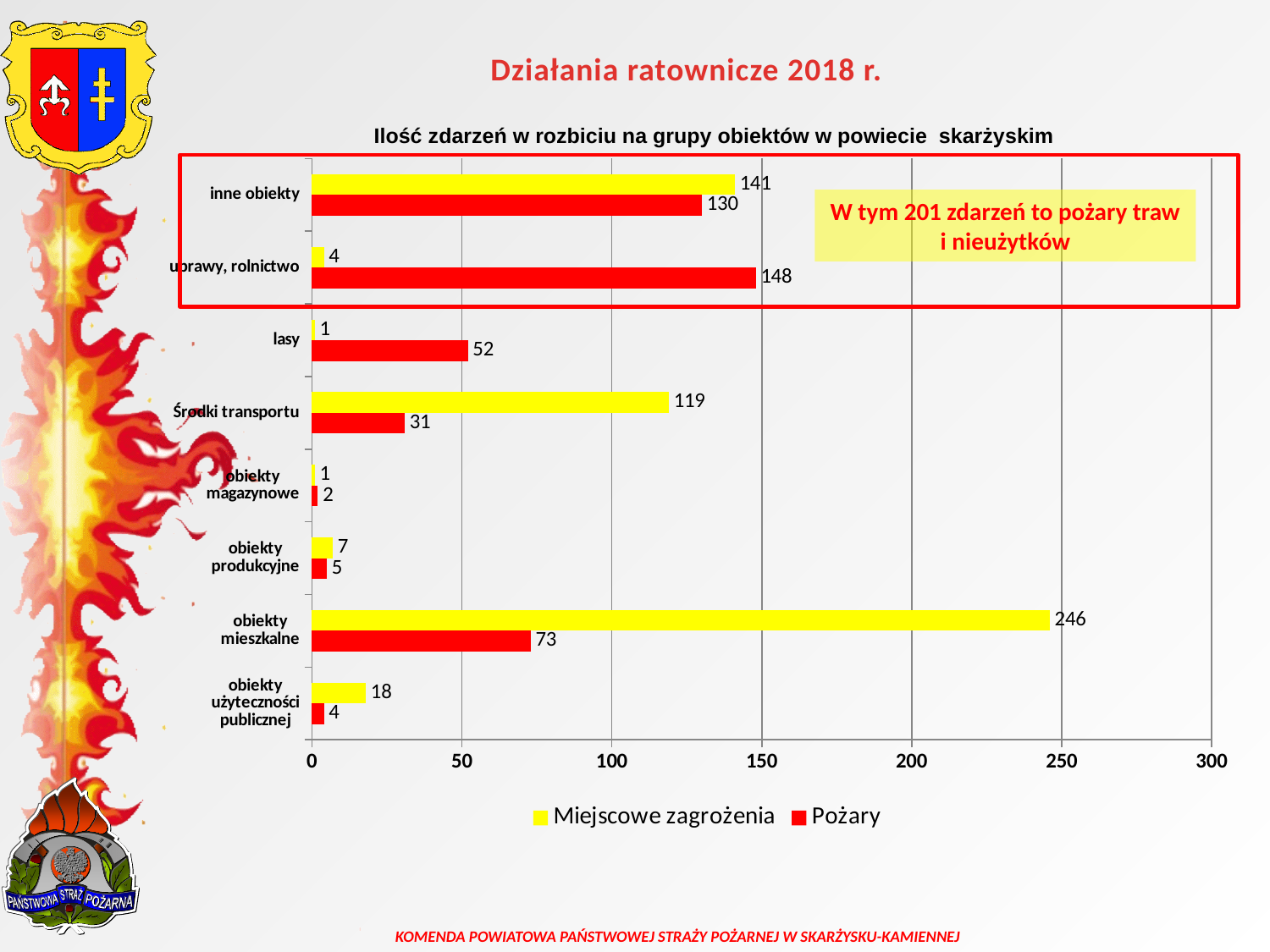
What is the value of Pożary for uprawy, rolnictwo? 148 How many series does the legend list? 2 What type of chart is shown on the slide? bar chart How many categories are shown on the chart? 8 For inne obiekty, which is larger: Miejscowe zagrożenia or Pożary? Miejscowe zagrożenia What is the difference between Miejscowe zagrożenia and Pożary for obiekty mieszkalne? 173 What is the value of Miejscowe zagrożenia for obiekty mieszkalne? 246 Is the value of Pożary for obiekty mieszkalne greater or less than 100? less What is the value of Miejscowe zagrożenia for Środki transportu? 119 Which category has the highest value for Pożary? uprawy, rolnictwo Which category has the highest value for Miejscowe zagrożenia? obiekty mieszkalne What is the value of Pożary for lasy? 52